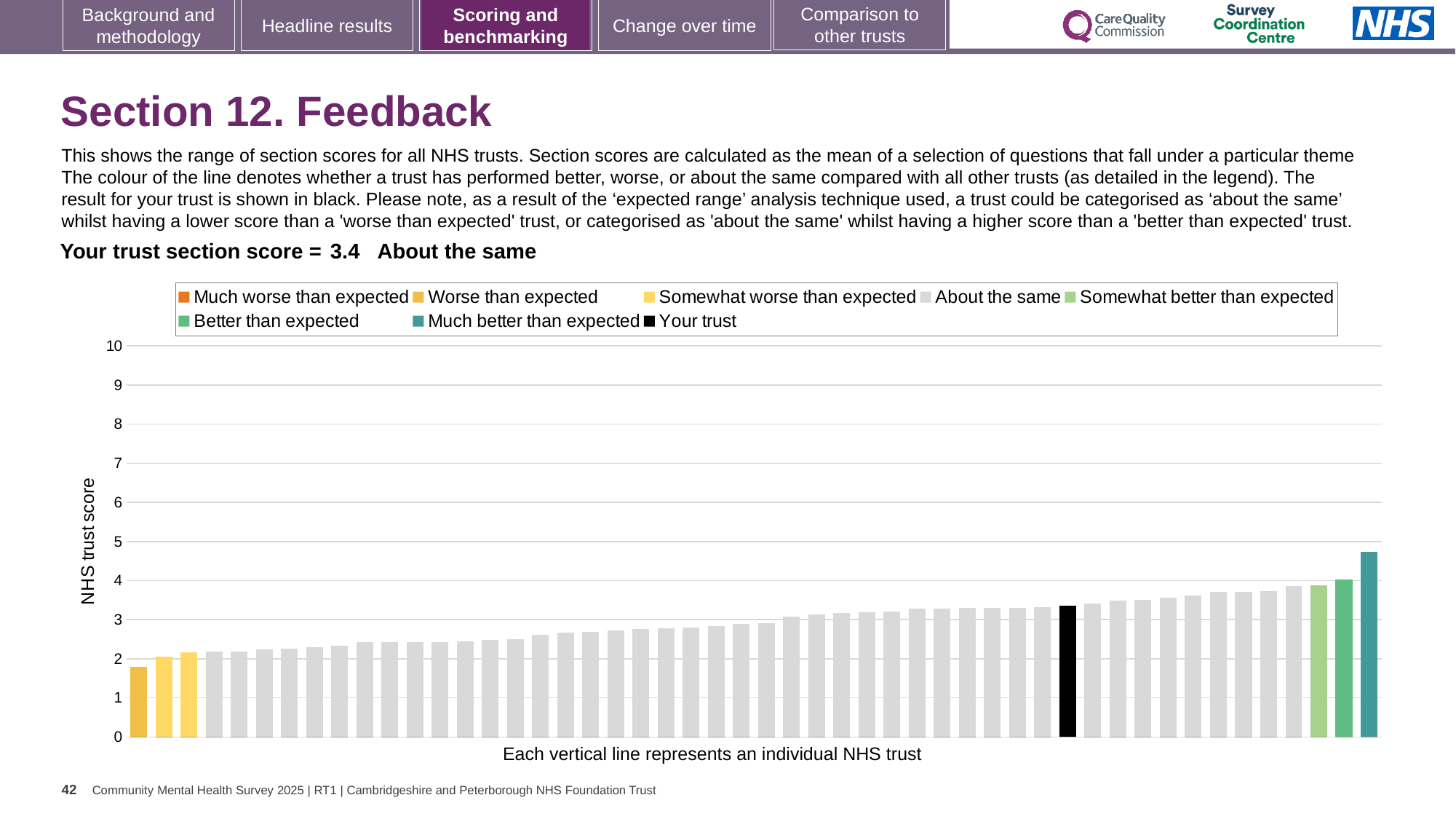
What is the label on the vertical axis of the chart? NHS trust score What is the section score for your trust shown on the slide? 3.4 Which legend category does the tallest bar belong to? Much better than expected Is the value of the shortest bar in the chart greater or less than 2? less Do the bar values rise or fall from left to right across the chart? rise How many entries does the chart legend list? 8 How many bars are coloured as 'Somewhat worse than expected'? 2 Is the value of the black 'Your trust' bar greater or less than 3? greater What kind of chart is shown on the slide? bar chart Is the value of the tallest bar in the chart greater or less than 4? greater Which category is your trust placed in for Section 12 Feedback? About the same Which legend category does the shortest bar belong to? Worse than expected